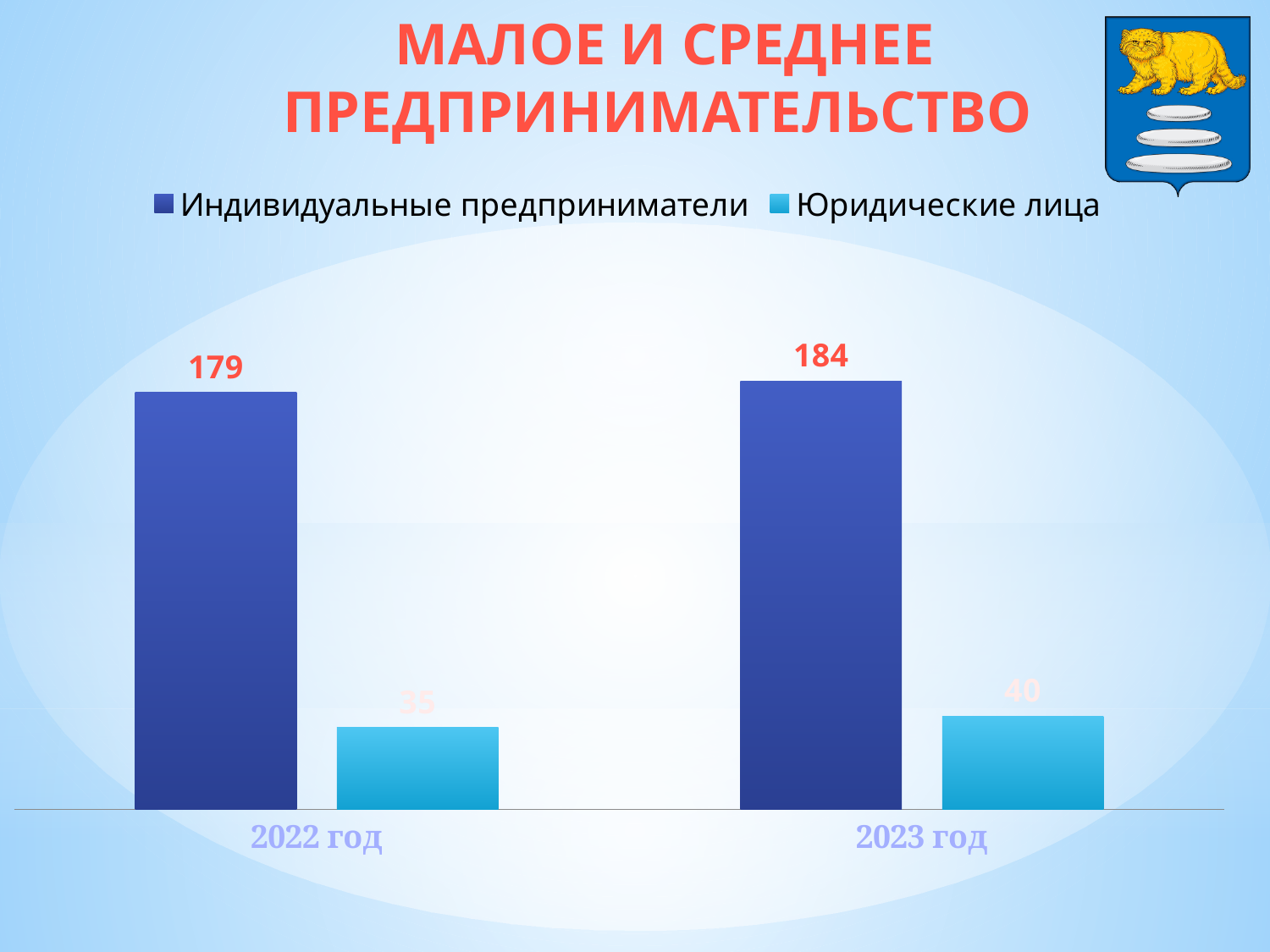
Which is larger in 2023 год: Индивидуальные предприниматели or Юридические лица? Индивидуальные предприниматели What is the value for Юридические лица in 2023 год? 40 What is the difference between the Индивидуальные предприниматели values for 2023 год and 2022 год? 5 What is the value for Индивидуальные предприниматели in 2022 год? 179 In which year is the value for Индивидуальные предприниматели highest? 2023 год How many series does the legend list? 2 What kind of chart is shown on the slide? Bar chart What is the difference between Индивидуальные предприниматели and Юридические лица in 2022 год? 144 What is the value for Юридические лица in 2022 год? 35 How many categories are shown on the x axis? 2 In which year is the value for Юридические лица lowest? 2022 год What is the value for Индивидуальные предприниматели in 2023 год? 184